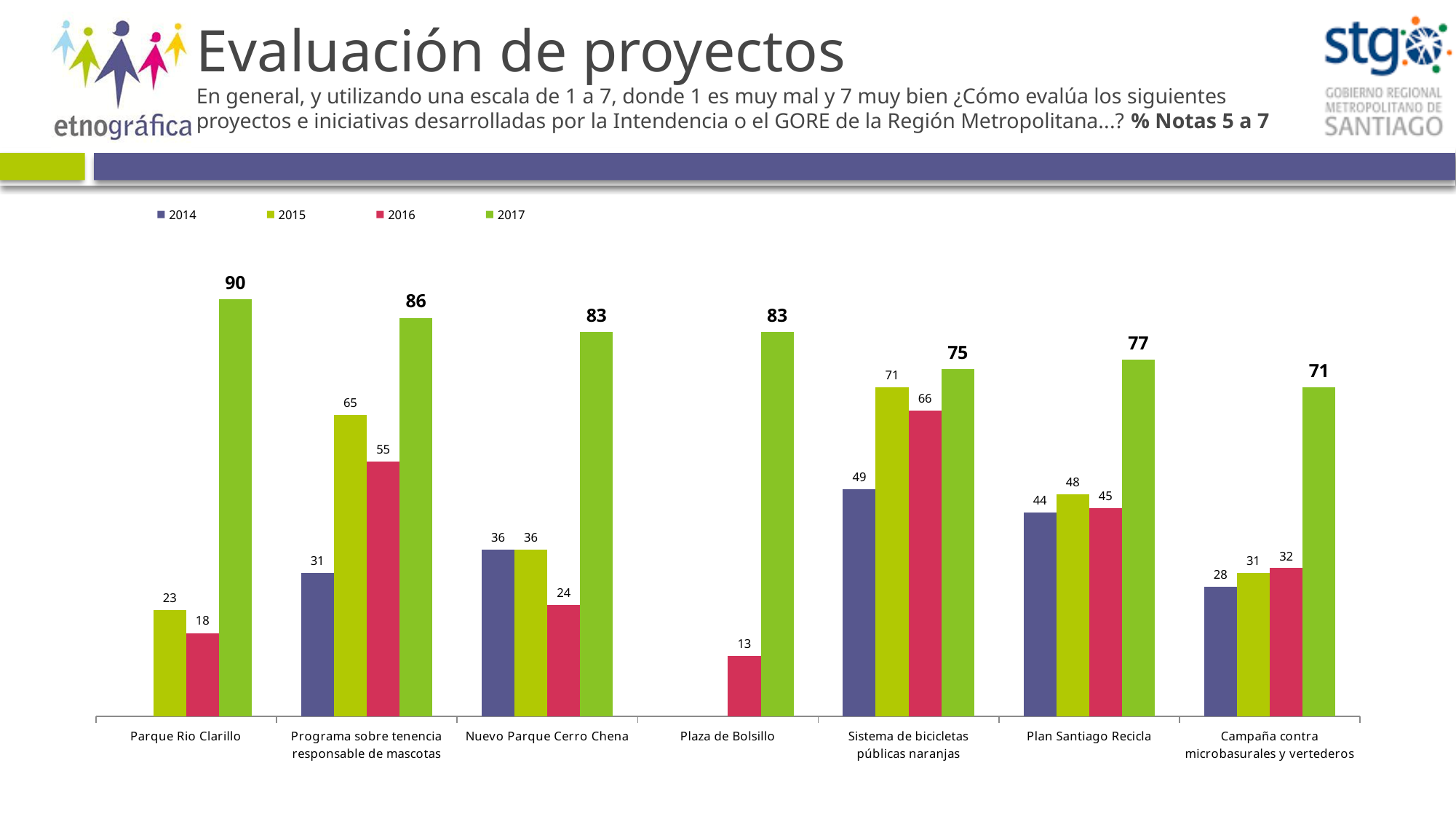
Which category has the lowest 2016 value? Plaza de Bolsillo Which is larger for Campaña contra microbasurales y vertederos: the 2015 value or the 2016 value? 2016 What is the 2016 value for Plaza de Bolsillo? 13 Which year is shown in red in the legend? 2016 What is the 2017 value for Parque Rio Clarillo? 90 How many categories are shown on the x axis? 7 What kind of chart is shown on the slide? Bar chart What is the 2015 value for Sistema de bicicletas públicas naranjas? 71 Which category has the highest 2017 value? Parque Rio Clarillo What is the 2014 value for Plan Santiago Recicla? 44 What is the difference between the 2017 and 2016 values for Programa sobre tenencia responsable de mascotas? 31 How many series does the legend list? 4